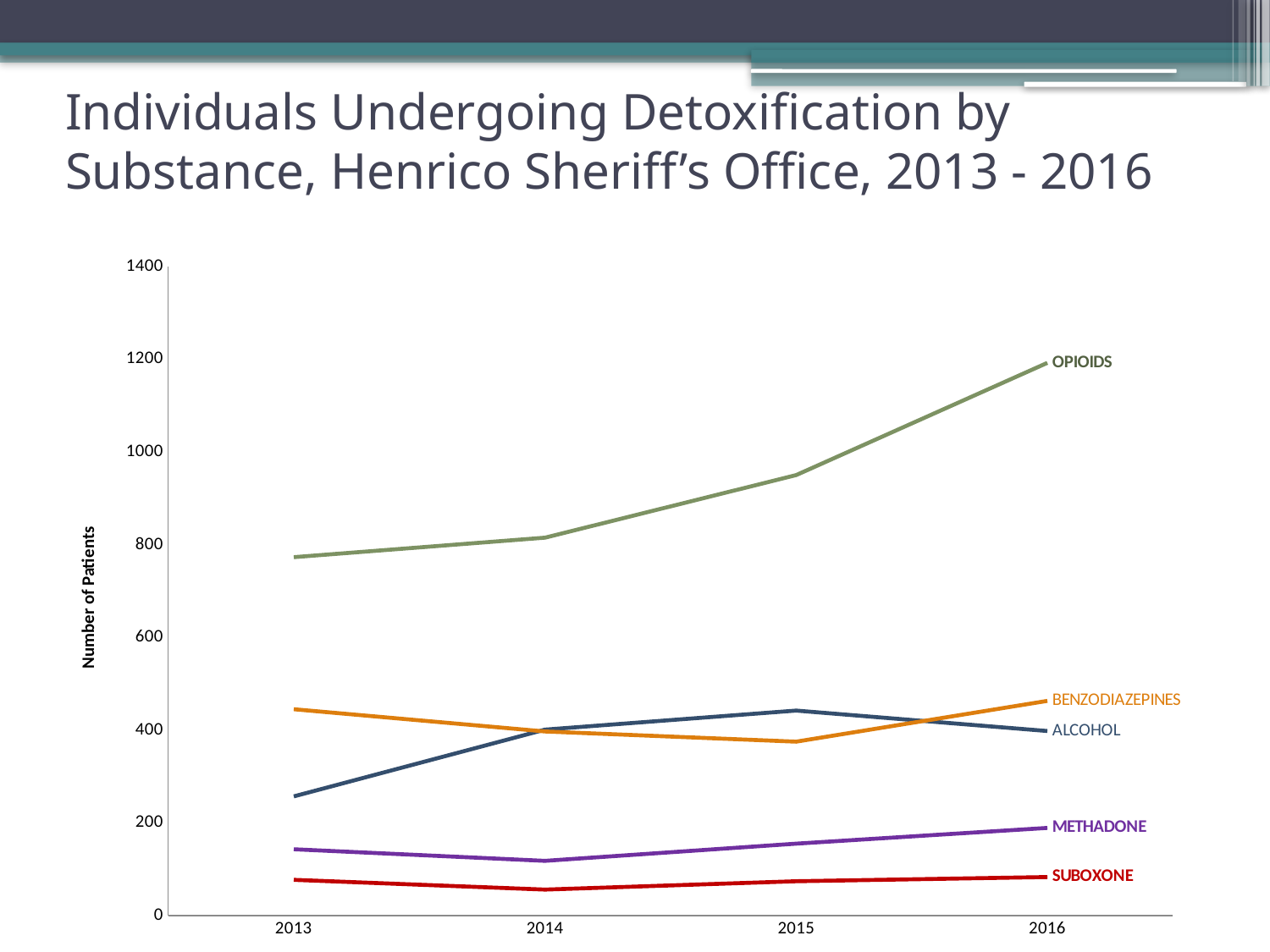
Do the values for Opioids rise or fall from 2013 to 2016? rise How many substance series are plotted on the chart? 5 What is the label on the y axis of the chart? Number of Patients Which is larger in 2013, the value for Benzodiazepines or the value for Alcohol? Benzodiazepines Which substance has the highest number of patients in 2016? Opioids How many years are shown along the x axis? 4 Is the value for Methadone in 2014 greater or less than 200? less What kind of chart is shown on the slide? line chart Is the value for Alcohol in 2013 greater or less than 400? less Which is larger in 2015, the value for Methadone or the value for Suboxone? Methadone Is the value for Opioids in 2016 greater or less than 1000? greater Which substance has the lowest number of patients in 2016? Suboxone